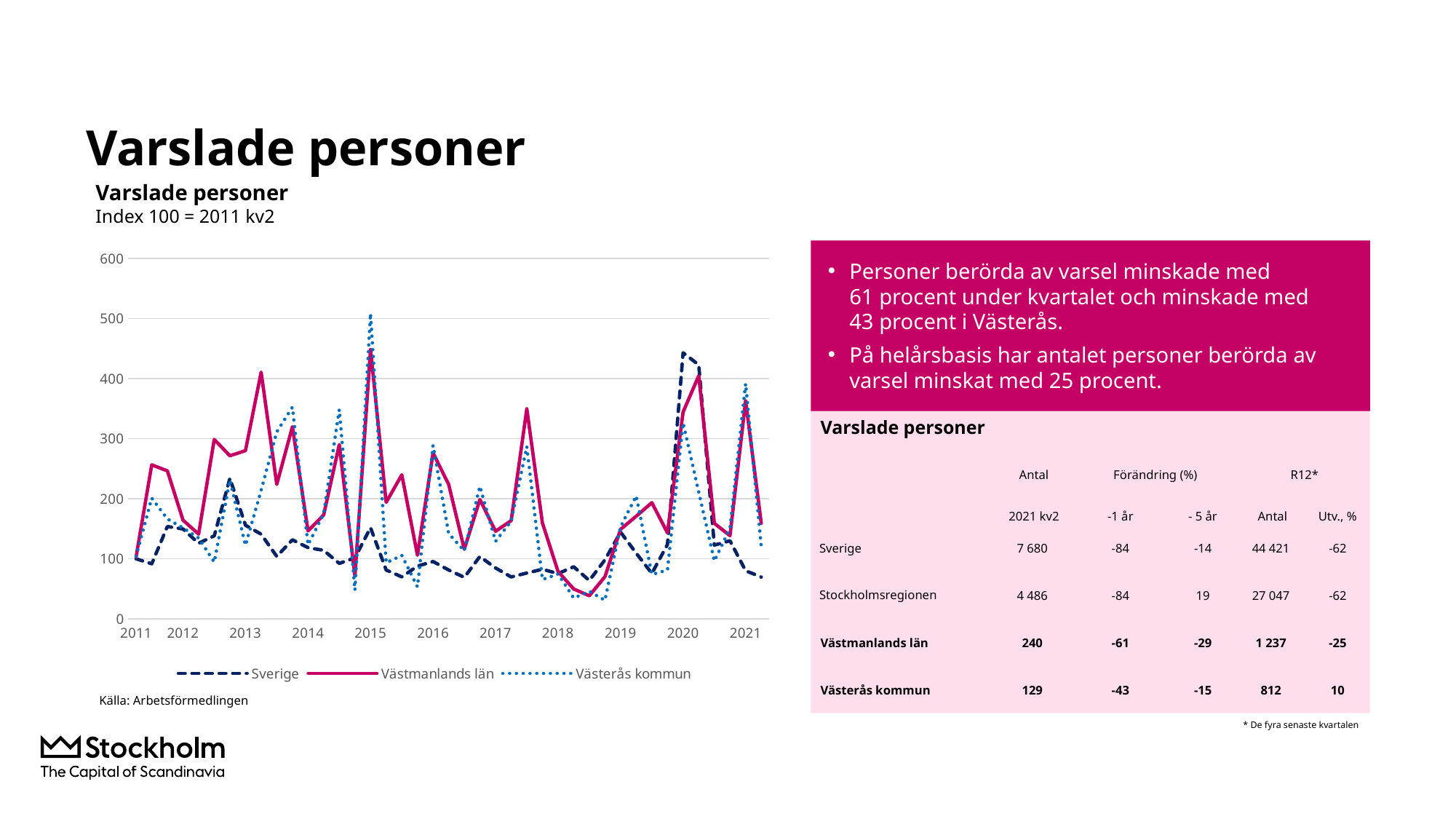
What base period does the chart's index use (Index 100)? 2011 kv2 Which series reaches the highest value anywhere on the chart? Västerås kommun From its peak around 2020 to the end of 2021, does the Sverige line rise or fall? fall How many years are labelled on the x axis of the chart? 11 What is the title of the chart? Varslade personer What kind of chart is shown on the slide? line chart Is the value for Sverige at the last point in 2021 greater or less than 100? less Is the lowest value of Västmanlands län around 2018 greater or less than 100? less How many series does the chart legend list? 3 Is the peak value of Sverige around 2020 greater or less than 400? greater At the 2013 peak, which is larger: Västmanlands län or Sverige? Västmanlands län